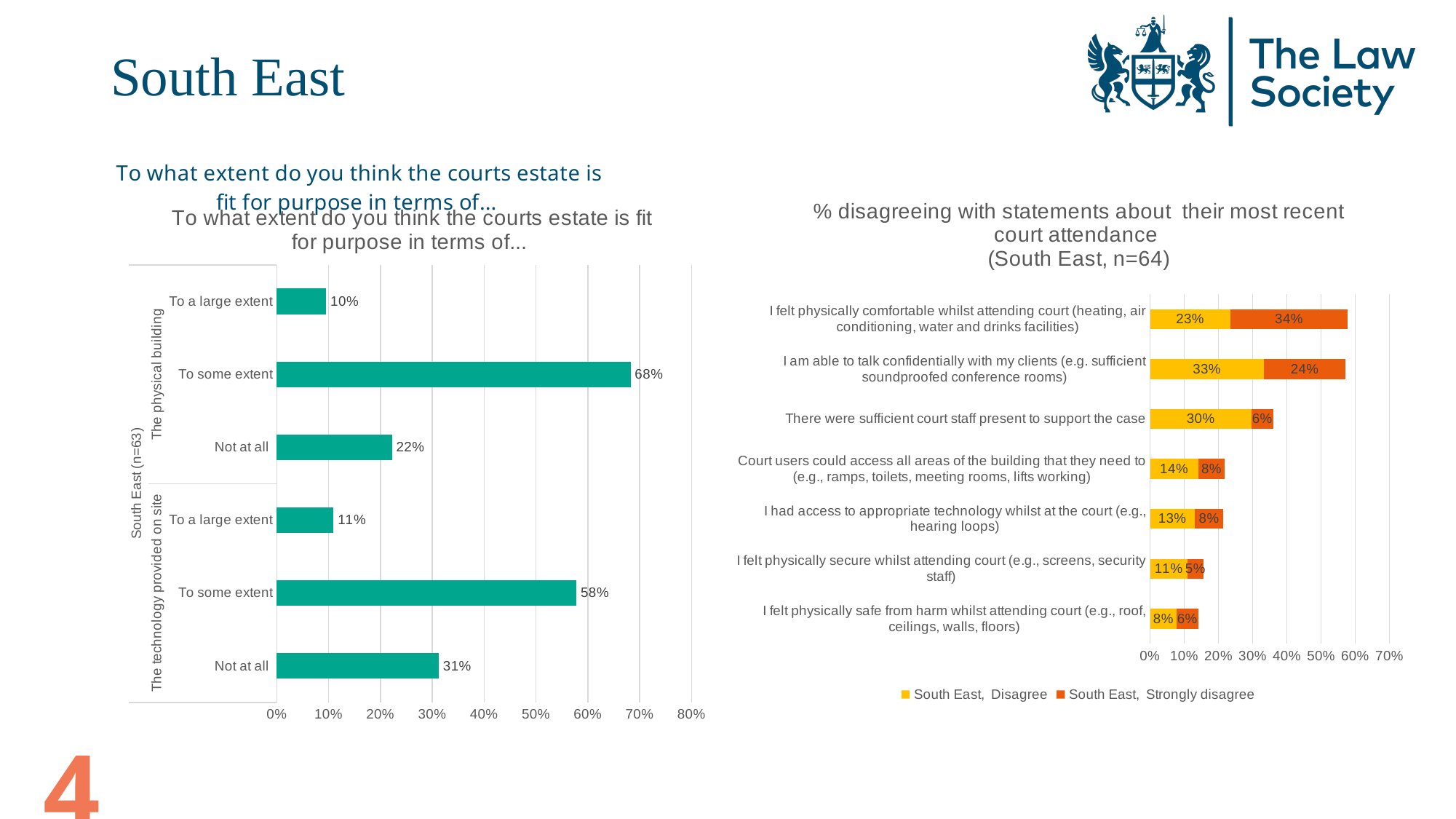
What kind of chart is the left chart? Bar chart In the left chart, what percentage said the technology provided on site is fit for purpose 'Not at all'? 31% In the left chart, which is larger: 'Not at all' for the physical building or 'Not at all' for the technology provided on site? The technology provided on site In the right chart, what percentage strongly disagreed that they felt physically comfortable whilst attending court? 34% In the right chart, which statement has the highest 'Strongly disagree' percentage? I felt physically comfortable whilst attending court (heating, air conditioning, water and drinks facilities) In the left chart, what is the difference between 'To some extent' for the physical building and 'To some extent' for the technology provided on site? 10% In the left chart, what percentage said the physical building is fit for purpose 'To some extent'? 68% In the right chart, what percentage disagreed that there were sufficient court staff present to support the case? 30% How many series does the legend of the right chart list? 2 In the right chart, what is the total percentage disagreeing (Disagree plus Strongly disagree) that they were able to talk confidentially with their clients? 57% How many statements are shown in the right chart? 7 In the left chart, which response for the physical building has the lowest percentage? To a large extent